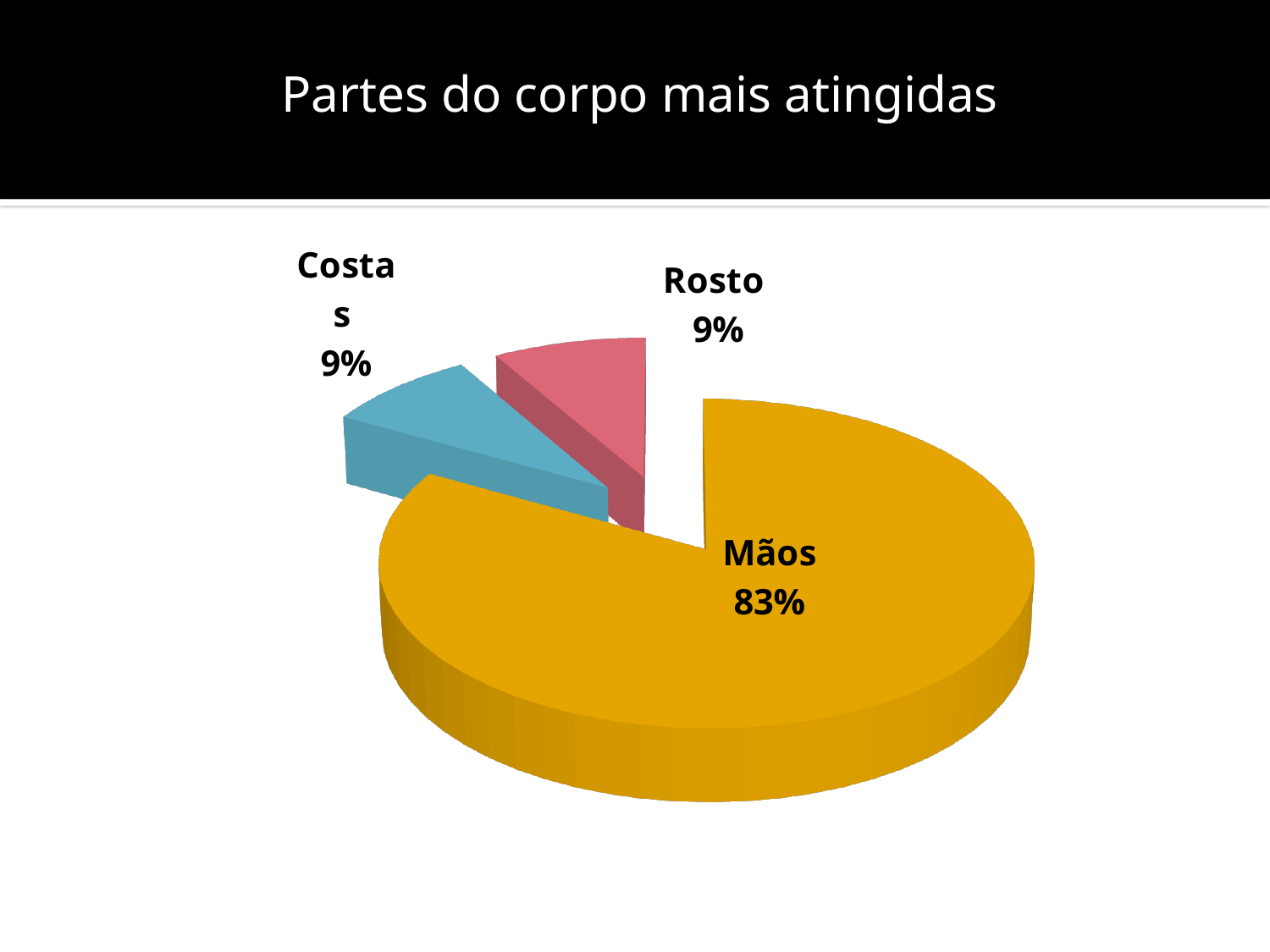
Which category has the largest slice of the pie? Mãos What is the value shown for Costas? 9% What share of the pie does Mãos represent? 83% What kind of chart is shown on the slide? Pie chart Is the value for Mãos greater or less than 50%? greater What is the difference in percentage points between Mãos and Costas? 74 percentage points What is the value shown for Rosto? 9% How many categories are shown in the pie chart? 3 Which two categories have the same value of 9%? Costas and Rosto What is the title of the slide? Partes do corpo mais atingidas What colour is the slice for Mãos? Yellow/orange Which is larger, the slice for Mãos or the slice for Rosto? Mãos